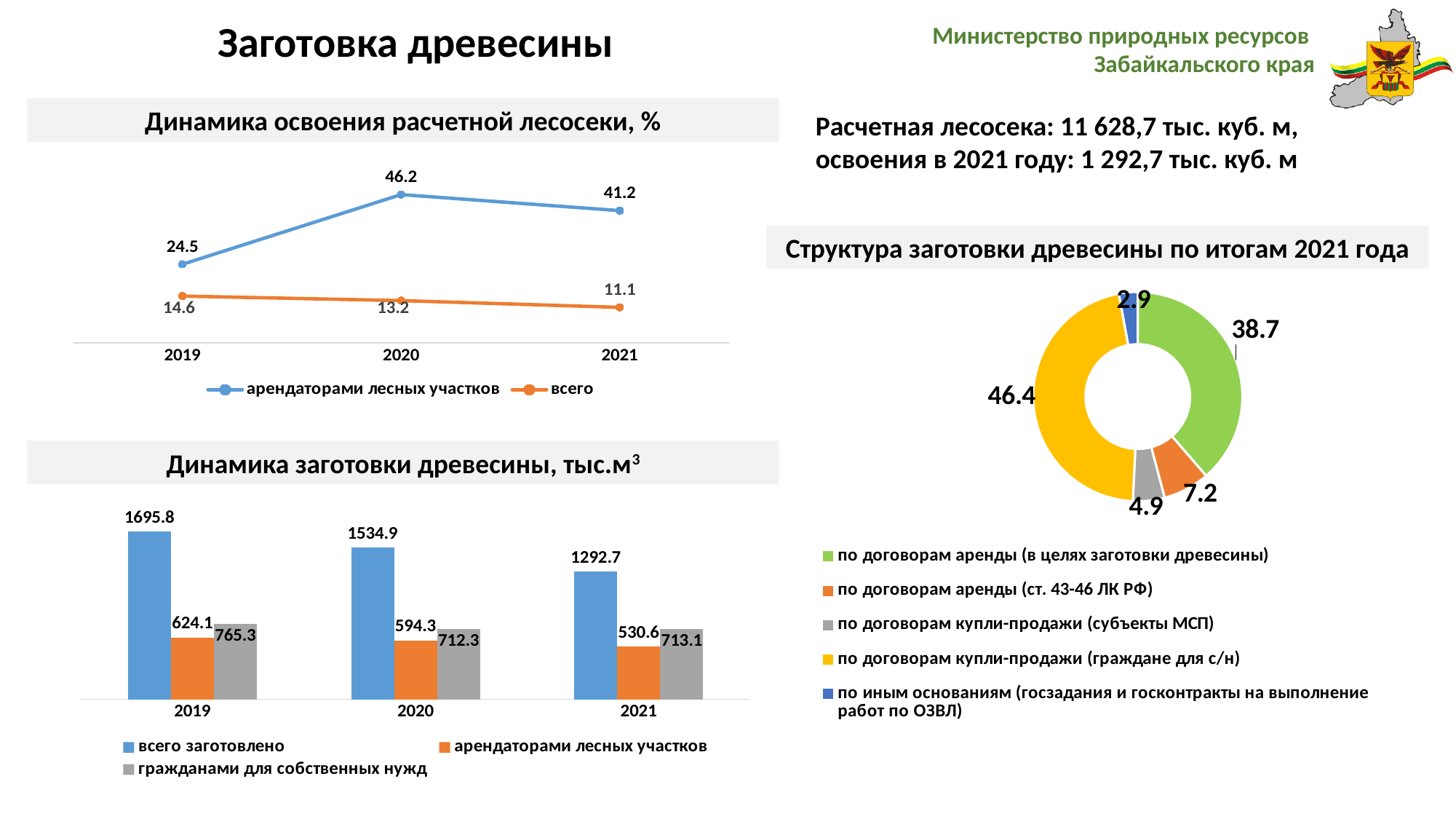
In the chart 'Структура заготовки древесины по итогам 2021 года', what is the share for 'по договорам купли-продажи (граждане для с/н)'? 46.4 In the chart 'Структура заготовки древесины по итогам 2021 года', which category has the smallest share? по иным основаниям (госзадания и госконтракты на выполнение работ по ОЗВЛ) In the chart 'Динамика заготовки древесины, тыс.м³', what kind of chart is it? bar chart In the chart 'Динамика освоения расчетной лесосеки, %', does the 'всего' series rise or fall from 2019 to 2021? fall In the chart 'Динамика заготовки древесины, тыс.м³', what is the value for 'всего заготовлено' in 2021? 1292.7 In the chart 'Динамика освоения расчетной лесосеки, %', what kind of chart is it? line chart In the chart 'Динамика заготовки древесины, тыс.м³', which is larger in 2020: 'арендаторами лесных участков' or 'гражданами для собственных нужд'? гражданами для собственных нужд In the chart 'Динамика заготовки древесины, тыс.м³', what is the difference between 'всего заготовлено' in 2019 and in 2020? 160.9 In the chart 'Динамика освоения расчетной лесосеки, %', what is the value for 'всего' in 2021? 11.1 In the chart 'Динамика освоения расчетной лесосеки, %', what is the value for 'арендаторами лесных участков' in 2020? 46.2 In the chart 'Динамика заготовки древесины, тыс.м³', how many series does the legend list? 3 In the chart 'Динамика освоения расчетной лесосеки, %', in which year is the 'арендаторами лесных участков' series lowest? 2019